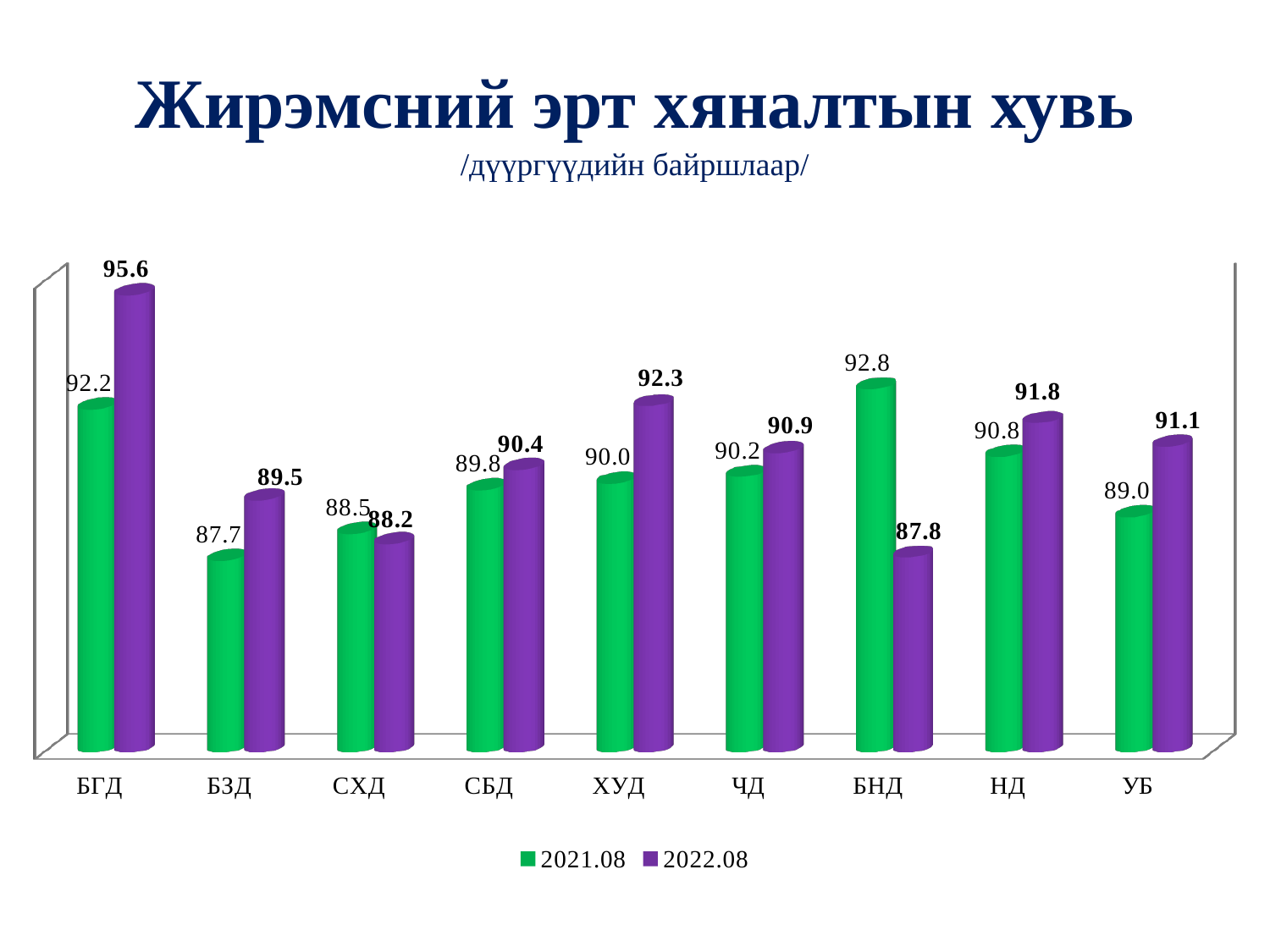
What kind of chart is shown on the slide? Bar chart What is the difference between the 2021.08 and 2022.08 values for БНД? 5.0 How many categories are shown on the x axis? 9 Which category has the lowest value in the 2021.08 series? БЗД What is the value for БГД in the 2022.08 series? 95.6 For СХД, which series has the larger value, 2021.08 or 2022.08? 2021.08 What is the difference between the 2022.08 and 2021.08 values for БГД? 3.4 What is the value for УБ in the 2022.08 series? 91.1 Which category has the highest value in the 2022.08 series? БГД Which category has the lowest value in the 2022.08 series? БНД What is the value for БНД in the 2021.08 series? 92.8 How many series does the legend list? 2